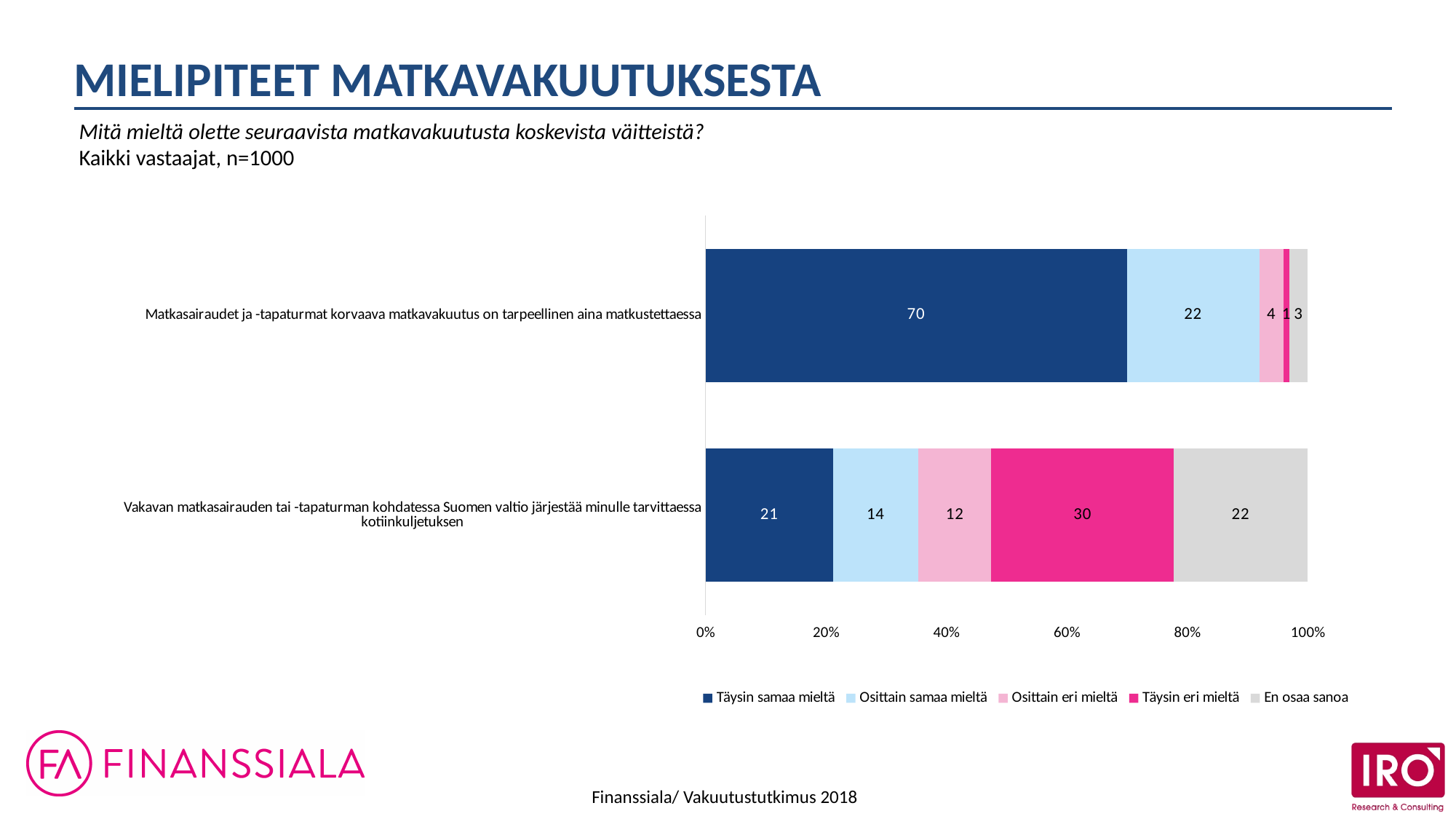
How many series does the legend list? 5 For the statement 'Vakavan matkasairauden tai -tapaturman kohdatessa Suomen valtio järjestää minulle tarvittaessa kotiinkuljetuksen', which response category has the highest value? Täysin eri mieltä What is the difference between the 'Täysin samaa mieltä' values of the two statements? 49 What is the combined value of 'Täysin samaa mieltä' and 'Osittain samaa mieltä' for the statement 'Vakavan matkasairauden tai -tapaturman kohdatessa Suomen valtio järjestää minulle tarvittaessa kotiinkuljetuksen'? 35 What is the value for 'Osittain samaa mieltä' for the statement 'Matkasairaudet ja -tapaturmat korvaava matkavakuutus on tarpeellinen aina matkustettaessa'? 22 Which statement has the higher 'Täysin samaa mieltä' value? Matkasairaudet ja -tapaturmat korvaava matkavakuutus on tarpeellinen aina matkustettaessa How many statements (categories) are plotted in the chart? 2 What is the value for 'Täysin eri mieltä' for the statement 'Vakavan matkasairauden tai -tapaturman kohdatessa Suomen valtio järjestää minulle tarvittaessa kotiinkuljetuksen'? 30 What is the value for 'En osaa sanoa' for the statement 'Vakavan matkasairauden tai -tapaturman kohdatessa Suomen valtio järjestää minulle tarvittaessa kotiinkuljetuksen'? 22 What kind of chart is shown on the slide? Stacked bar chart For the statement 'Matkasairaudet ja -tapaturmat korvaava matkavakuutus on tarpeellinen aina matkustettaessa', which response category has the lowest value? Täysin eri mieltä What is the value for 'Täysin samaa mieltä' for the statement 'Matkasairaudet ja -tapaturmat korvaava matkavakuutus on tarpeellinen aina matkustettaessa'? 70